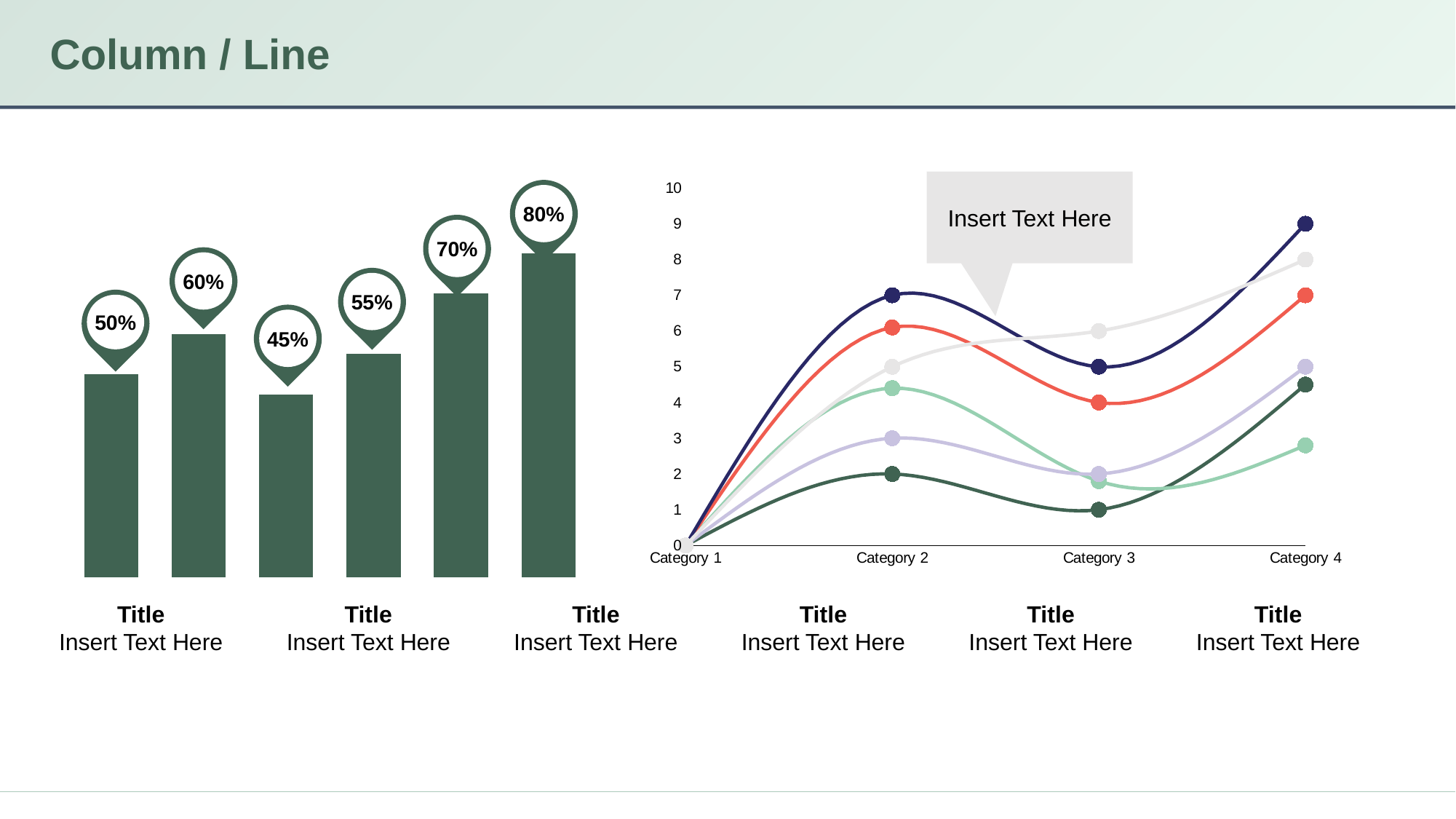
What type of chart is the chart on the left side of the slide? bar chart What type of chart is the chart on the right side of the slide? line chart In the bar chart on the left, which bar has the lowest value? the third bar, 45% In the line chart on the right, how many categories are shown on the x axis? 4 In the bar chart on the left, what is the value shown on the third bar from the left? 45% In the line chart on the right, what is the value of the dark navy line at Category 4? 9 In the line chart on the right, is the value of the dark green line at Category 3 greater or less than 2? less In the bar chart on the left, which is larger: the second bar or the fourth bar? the second bar (60%) In the bar chart on the left, which bar has the highest value? the sixth (rightmost) bar, 80% In the bar chart on the left, what is the difference between the rightmost bar (80%) and the leftmost bar (50%)? 30% In the bar chart on the left, how many bars are there? 6 In the bar chart on the left, what is the value shown on the first (leftmost) bar? 50%